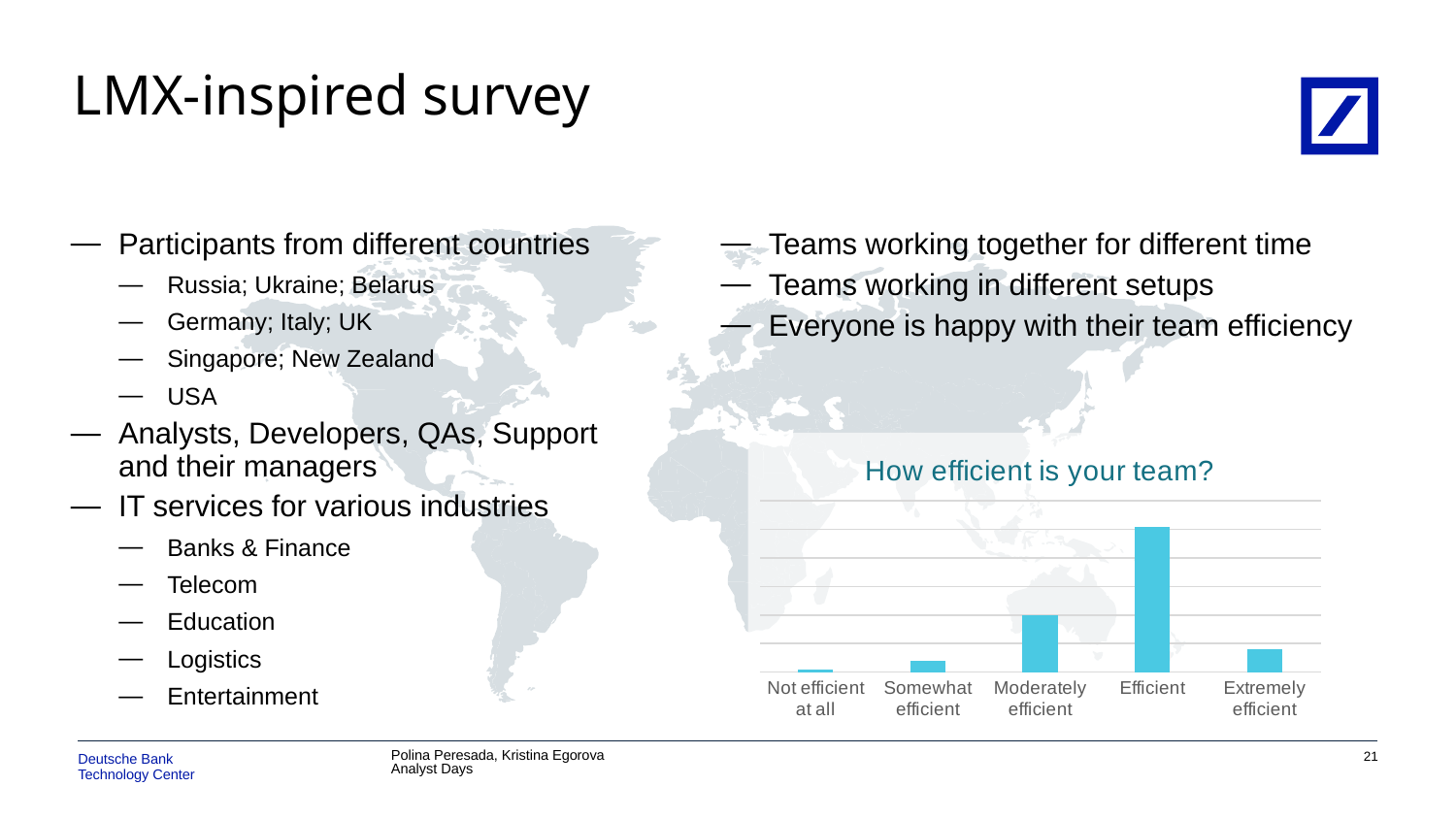
Which is larger, the bar for Efficient or the bar for Moderately efficient? Efficient Which category has the second-highest bar in the chart? Moderately efficient Which is larger, the bar for Not efficient at all or the bar for Somewhat efficient? Somewhat efficient Which is larger, the bar for Somewhat efficient or the bar for Extremely efficient? Extremely efficient Which category has the lowest bar in the chart? Not efficient at all What colour are the bars in the chart? light blue Which category has the highest bar in the chart? Efficient How many categories are shown on the x axis of the chart? 5 What kind of chart is shown on the slide? bar chart What is the title of the chart on the slide? How efficient is your team?